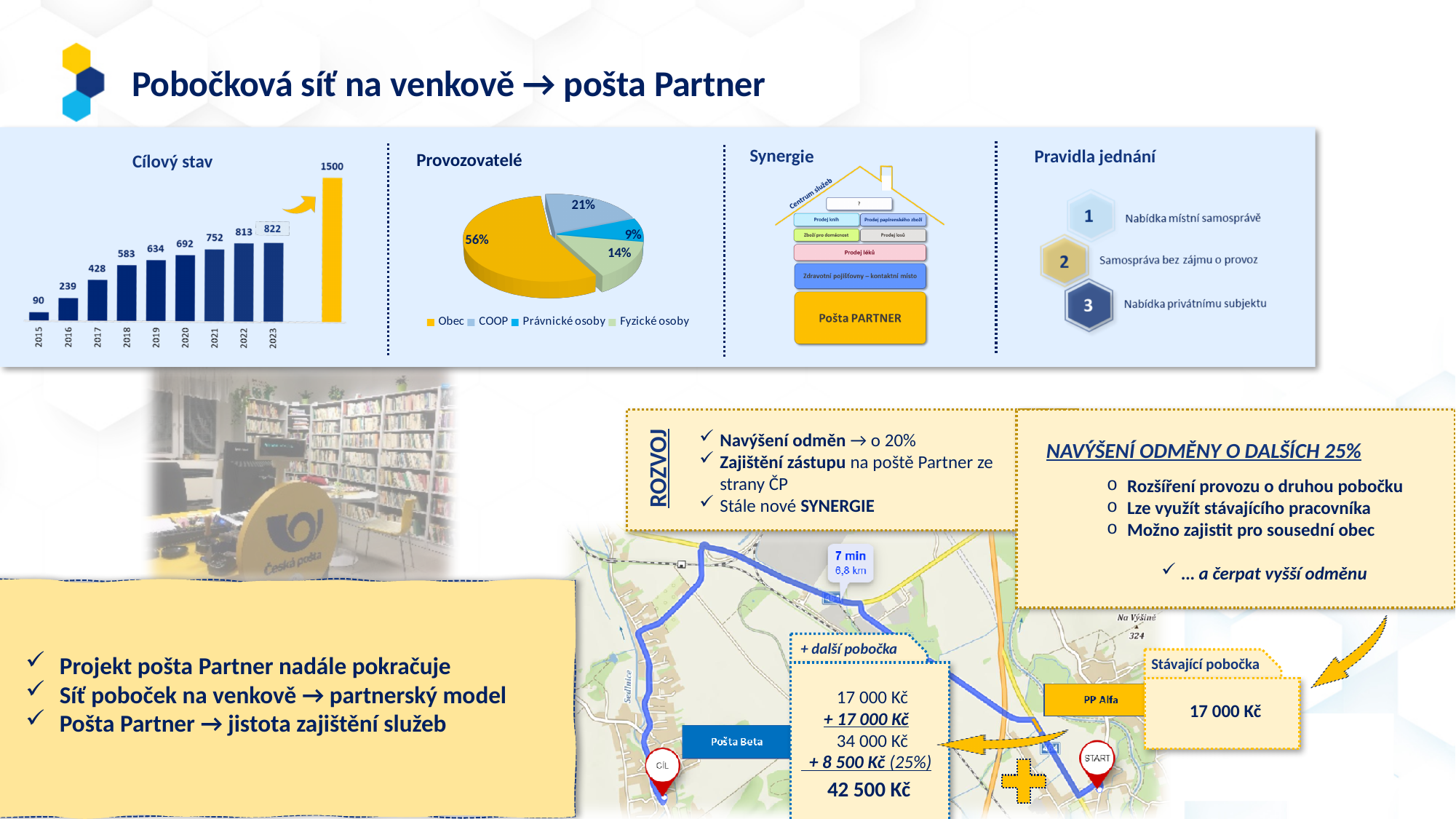
In the 'Cílový stav' bar chart, which year among 2015–2023 has the lowest value? 2015 In the 'Cílový stav' bar chart, what value is shown on the yellow target bar? 1500 In the 'Cílový stav' bar chart, how many years are labelled on the x axis? 9 In the 'Cílový stav' bar chart, what is the value for 2015? 90 In the 'Provozovatelé' pie chart, which category has the smallest share? Právnické osoby In the 'Provozovatelé' pie chart, what share does Obec have? 56% In the 'Cílový stav' bar chart, what is the value for 2018? 583 In the 'Provozovatelé' pie chart, what share does Fyzické osoby have? 14% How many categories does the legend of the 'Provozovatelé' pie chart list? 4 In the 'Cílový stav' bar chart, what is the difference between the values for 2023 and 2022? 9 What kind of chart is the 'Cílový stav' chart? bar chart In the 'Cílový stav' bar chart, do the values rise or fall from 2015 to 2023? rise